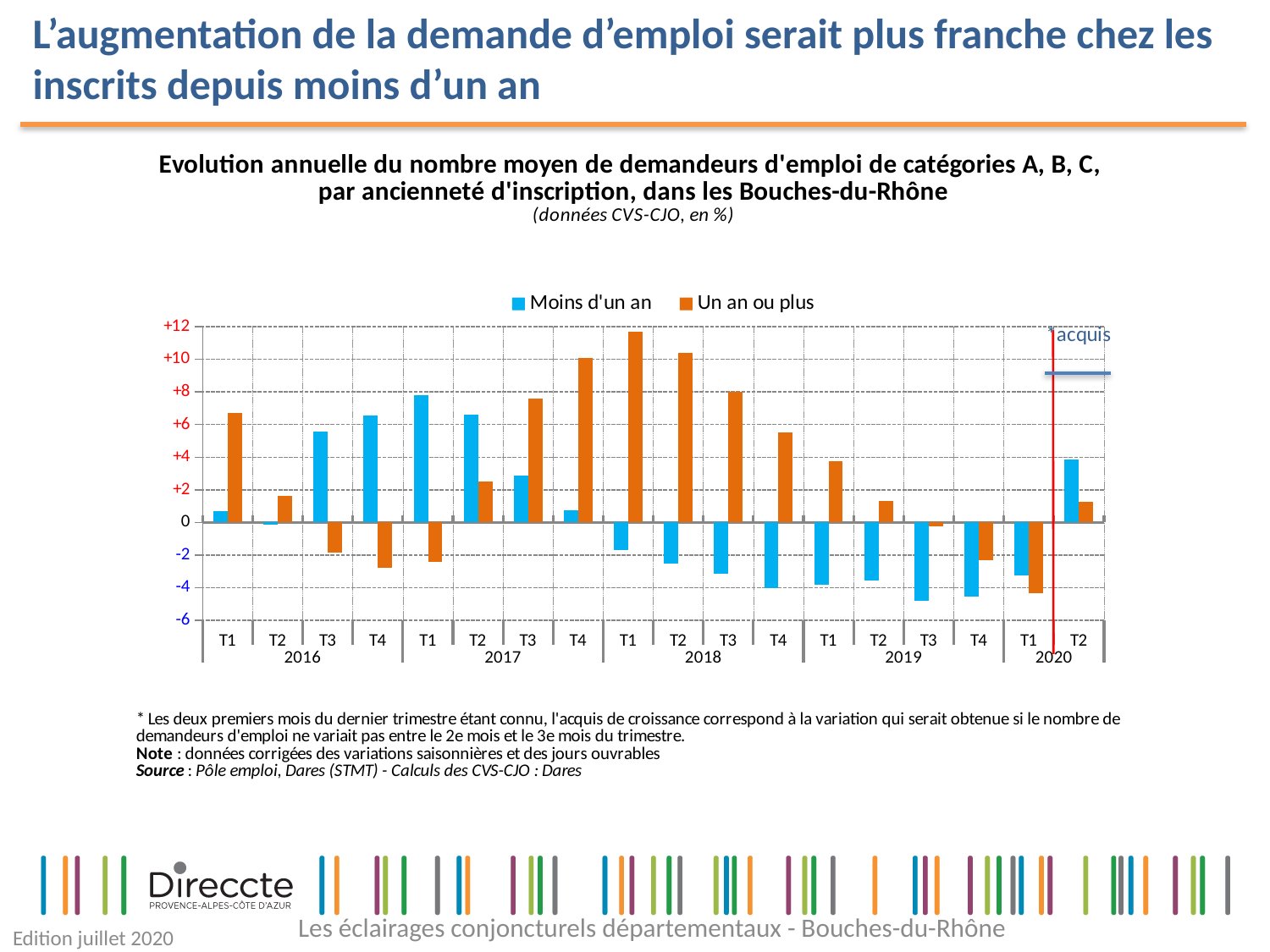
How many quarters are plotted along the x axis? 18 In T1 2016, which series has the larger value, 'Moins d'un an' or 'Un an ou plus'? Un an ou plus What kind of chart is shown on the slide? bar chart Is the value for 'Un an ou plus' in T1 2018 greater or less than +10? greater In which quarter does the 'Moins d'un an' series reach its highest value? T1 2017 What are the two series named in the legend? Moins d'un an; Un an ou plus In T2 2020, which series has the larger value, 'Moins d'un an' or 'Un an ou plus'? Moins d'un an How many series does the legend list? 2 In which quarter does the 'Un an ou plus' series reach its highest value? T1 2018 Is the value for 'Moins d'un an' in T1 2017 greater or less than +6? greater In which quarter does the 'Un an ou plus' series reach its lowest value? T1 2020 Is the value for 'Moins d'un an' in T3 2019 greater or less than -4? less